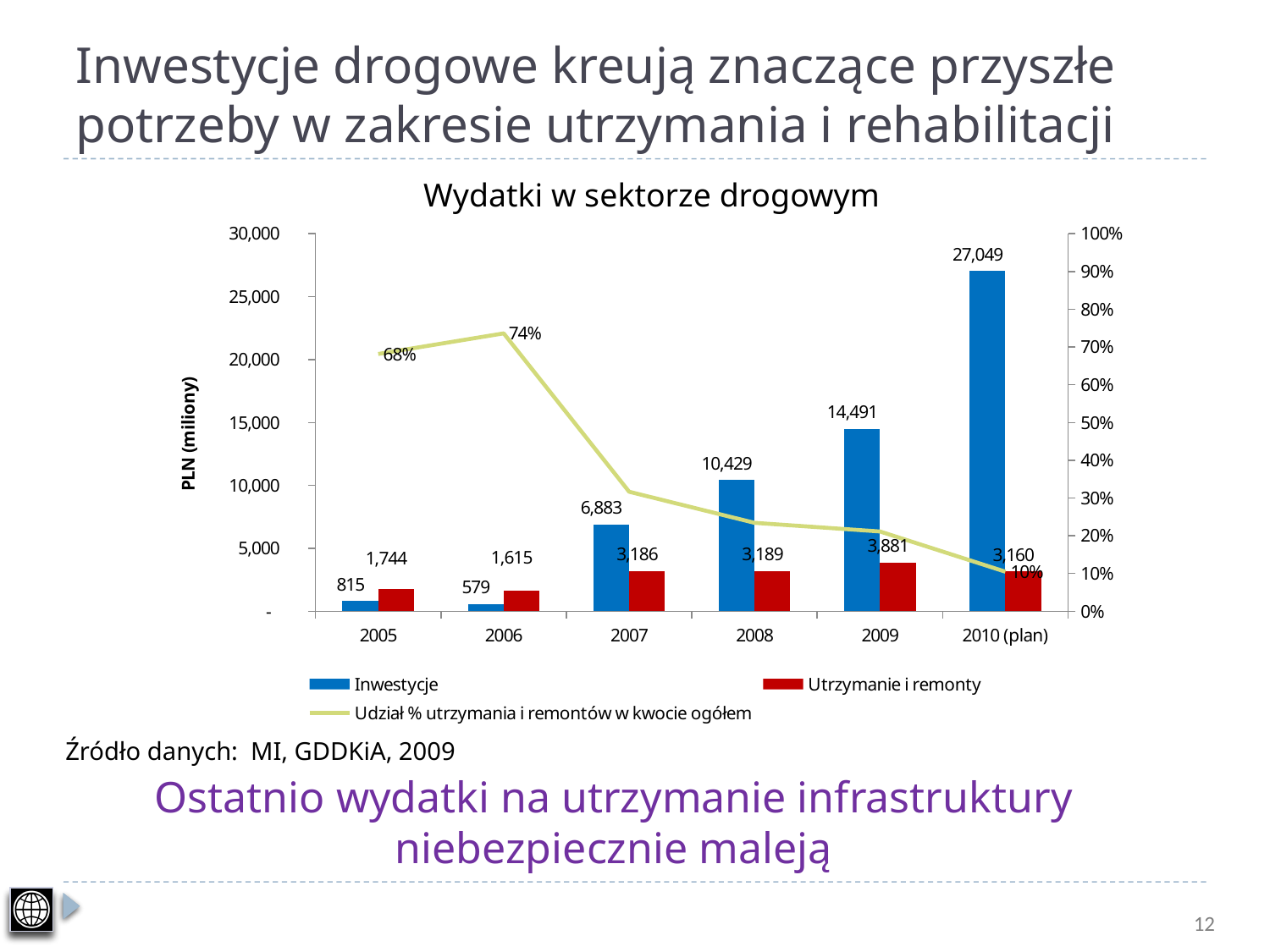
Which year has the lowest value for Utrzymanie i remonty? 2006 What is the value of the Udział % utrzymania i remontów w kwocie ogółem line for 2006? 74% What is the value of Utrzymanie i remonty for 2009? 3,881 What is the value of Inwestycje for 2006? 579 How many series does the legend list? 3 What is the difference between Inwestycje and Utrzymanie i remonty in 2008? 7,240 How many years are shown on the x axis? 6 Is the Udział % utrzymania i remontów w kwocie ogółem value for 2007 greater or less than 50%? less Which is larger in 2005, Inwestycje or Utrzymanie i remonty? Utrzymanie i remonty What is the value of Inwestycje for 2010 (plan)? 27,049 What is the title of the chart? Wydatki w sektorze drogowym Which year has the highest value for Inwestycje? 2010 (plan)